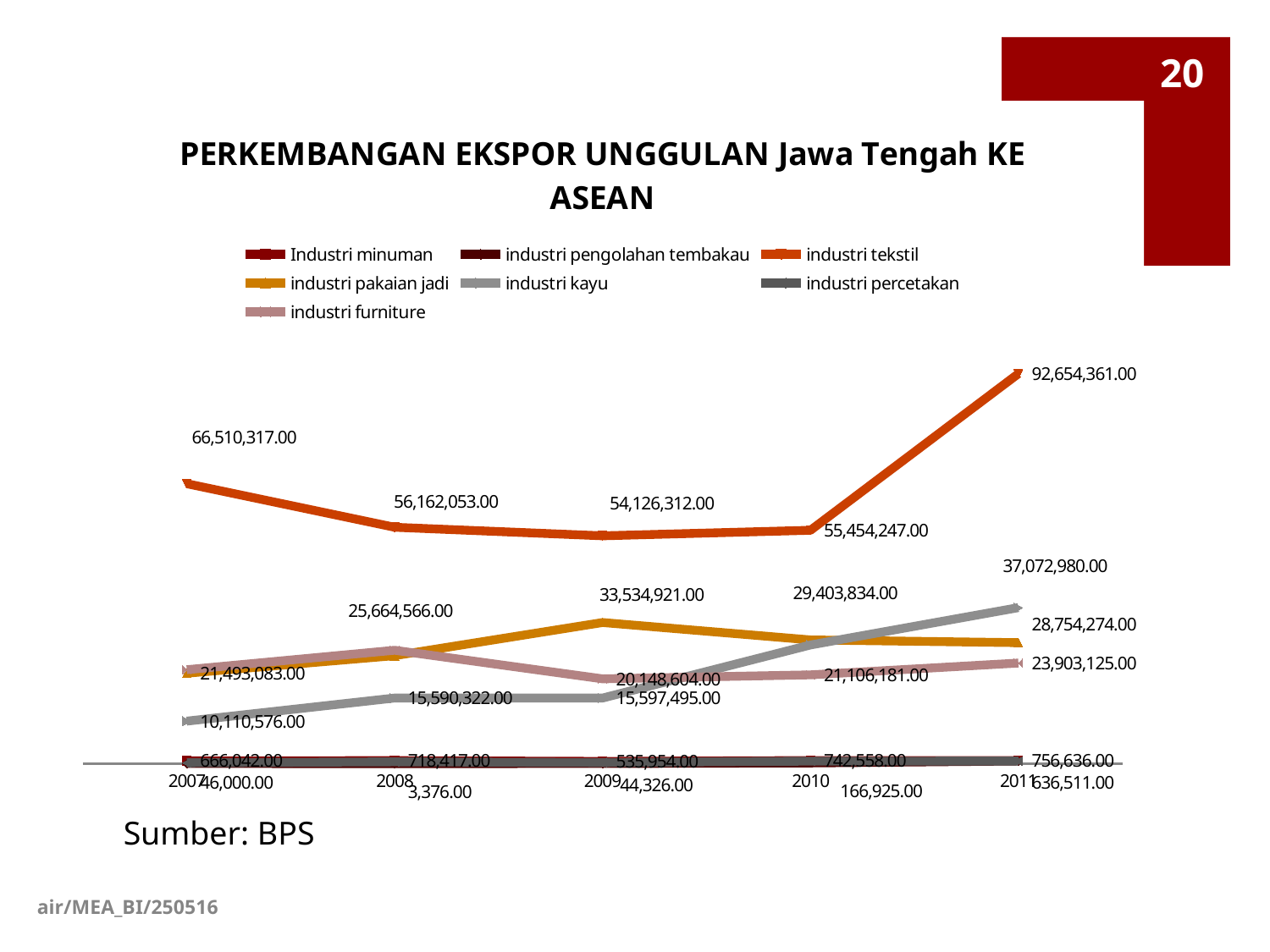
What is the value for industri tekstil in 2011? 92,654,361.00 What is the title of the chart? PERKEMBANGAN EKSPOR UNGGULAN Jawa Tengah KE ASEAN What kind of chart is shown on the slide? line chart In which year is the value for industri tekstil highest? 2011 What is the difference between the industri tekstil values in 2011 and 2007? 26,144,044.00 Which series has the larger value in 2011, industri tekstil or industri kayu? industri tekstil What is the value for industri kayu in 2011? 37,072,980.00 How many series does the legend list? 7 How many years are plotted along the x axis? 5 What is the value for industri tekstil in 2007? 66,510,317.00 In which year is the value for industri tekstil lowest? 2009 Does the value for industri kayu rise or fall from 2007 to 2011? rise